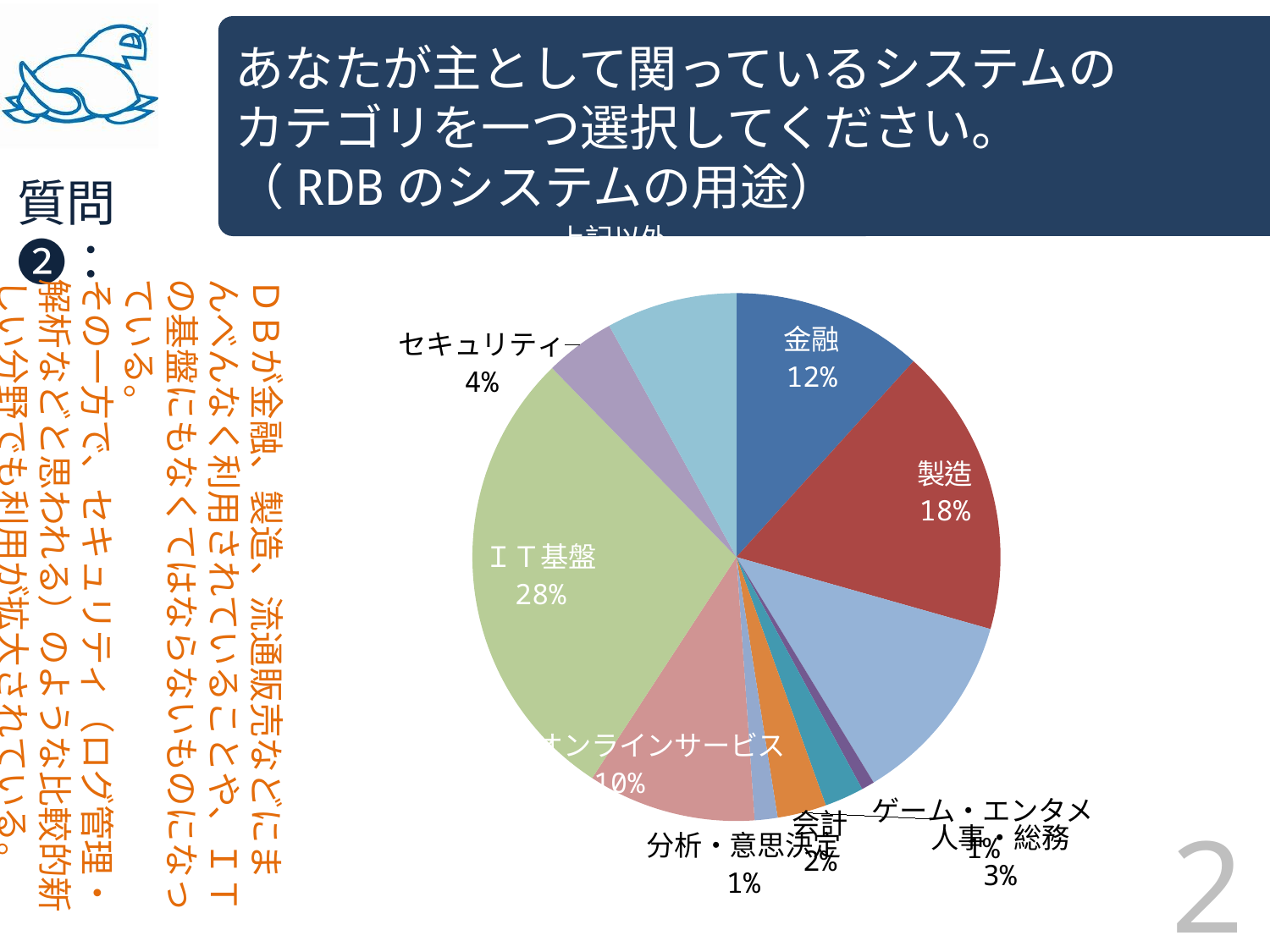
What percentage is shown for ＩＴ基盤? 28% What kind of chart is shown on the slide? pie chart Which is larger, the share for セキュリティ or the share for 人事・総務? セキュリティ What percentage is shown for 製造? 18% Which is larger, the share for 製造 or the share for 金融? 製造 What percentage is shown for オンラインサービス? 10% What percentage is shown for セキュリティ? 4% What share of the pie does 金融 represent? 12% Which labelled category has the largest share of the pie? ＩＴ基盤 What is the difference in percentage points between ＩＴ基盤 and オンラインサービス? 18% What percentage is shown for 人事・総務? 3% What is the difference in percentage points between 製造 and 金融? 6%